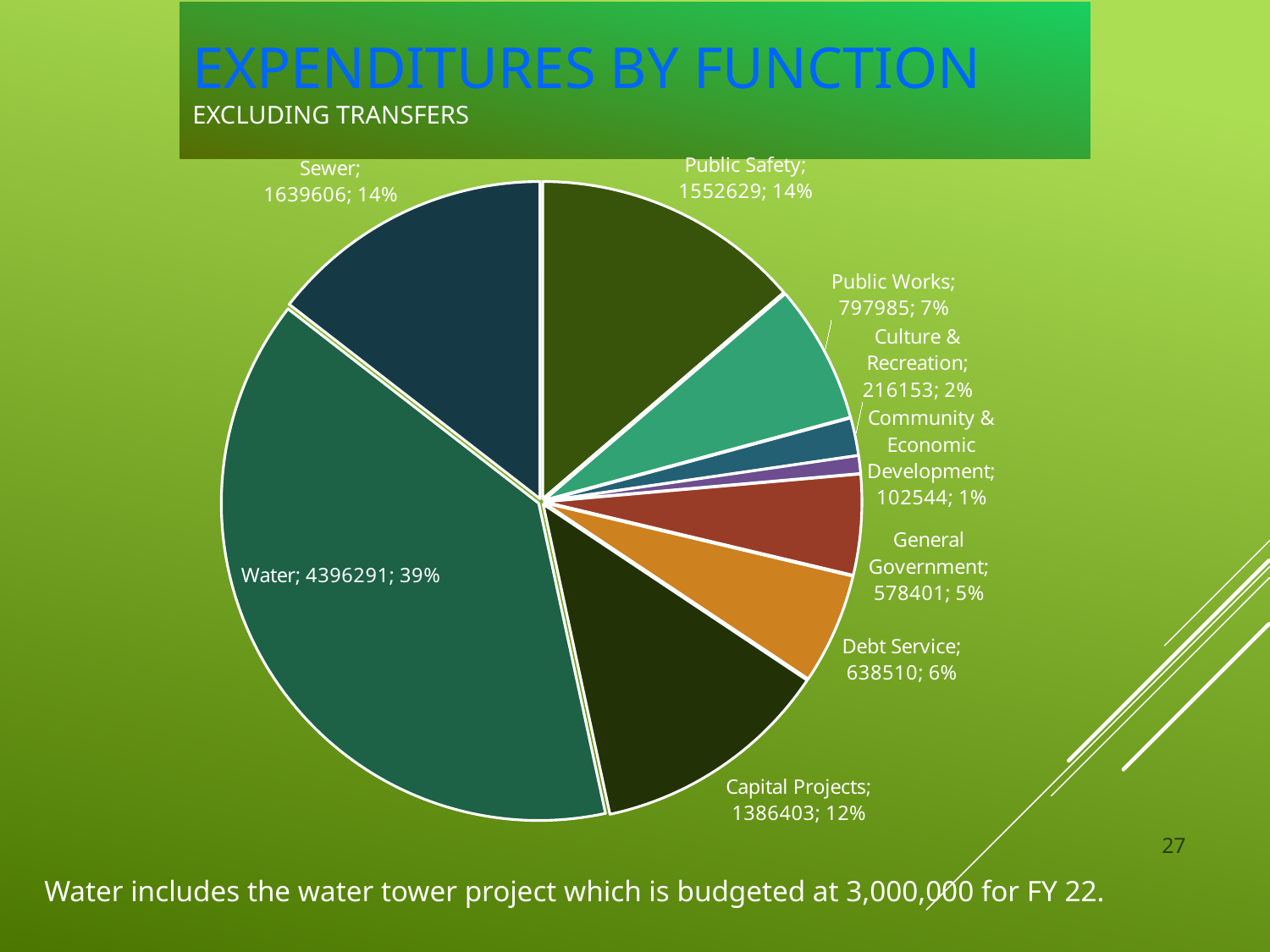
Which is larger, the value for General Government or the value for Debt Service? Debt Service What is the title of the chart on the slide? EXPENDITURES BY FUNCTION What is the difference between the values for Sewer and Public Safety? 86977 What share of the pie does Water represent? 39% What is the value for Water? 4396291 What share of the pie does Public Works represent? 7% How many slices does the pie chart have? 9 Which category has the largest slice? Water What kind of chart is shown on the slide? Pie chart What is the value for Capital Projects? 1386403 Which category has the smallest slice? Community & Economic Development What is the value for Debt Service? 638510